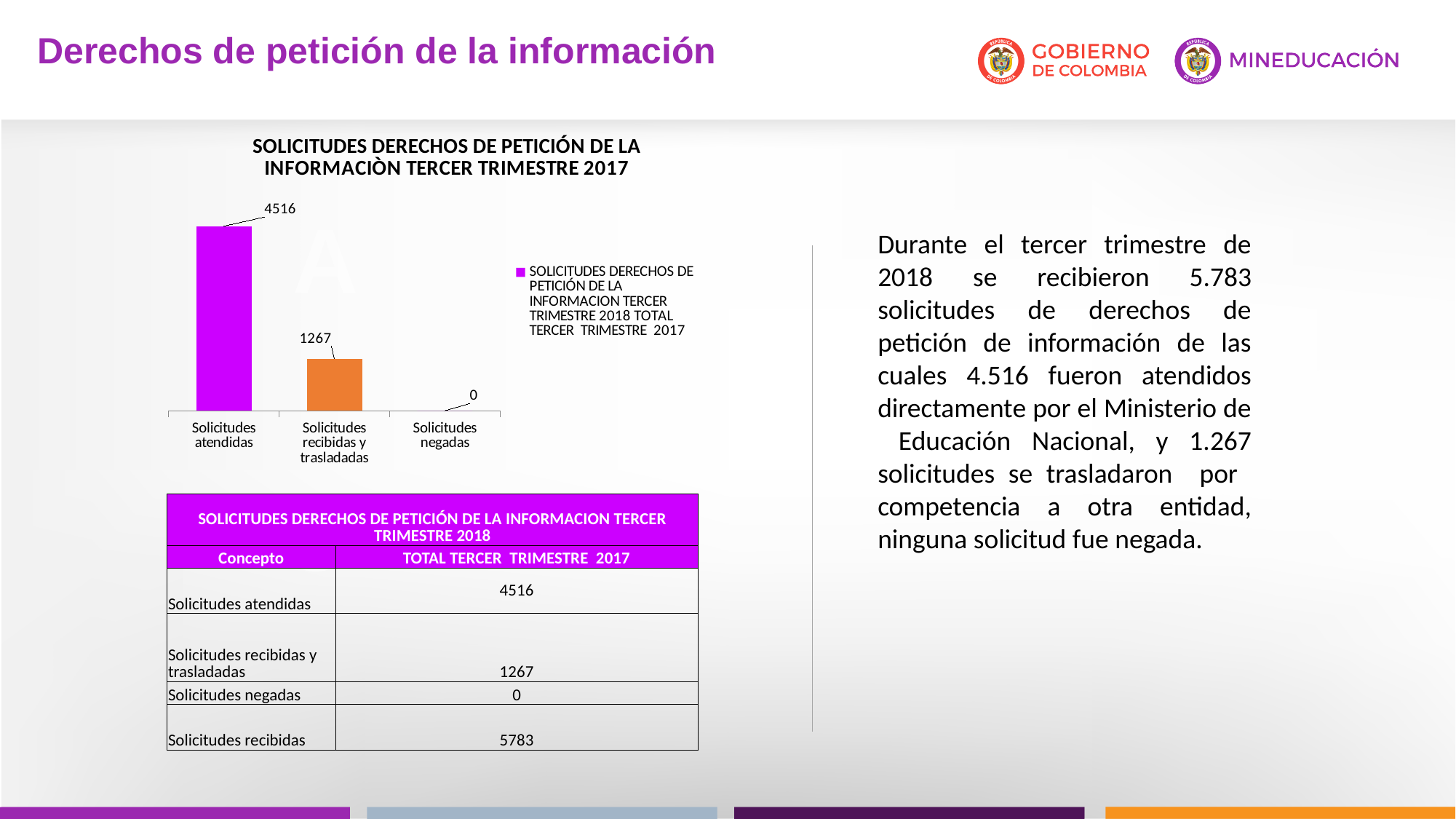
What is the value for Solicitudes atendidas in the chart? 4516 How many categories are shown on the x axis of the chart? 3 Do the values rise or fall from left to right across the categories in the chart? fall Which category has the highest value in the chart? Solicitudes atendidas What is the difference between the values for Solicitudes atendidas and Solicitudes recibidas y trasladadas? 3249 How many series does the chart legend list? 1 Which category has the lowest value in the chart? Solicitudes negadas What kind of chart is shown on the slide? bar chart What is the value for Solicitudes negadas in the chart? 0 Which is larger, the value for Solicitudes atendidas or the value for Solicitudes recibidas y trasladadas? Solicitudes atendidas What is the value for Solicitudes recibidas y trasladadas in the chart? 1267 What colour is the bar for Solicitudes recibidas y trasladadas? orange